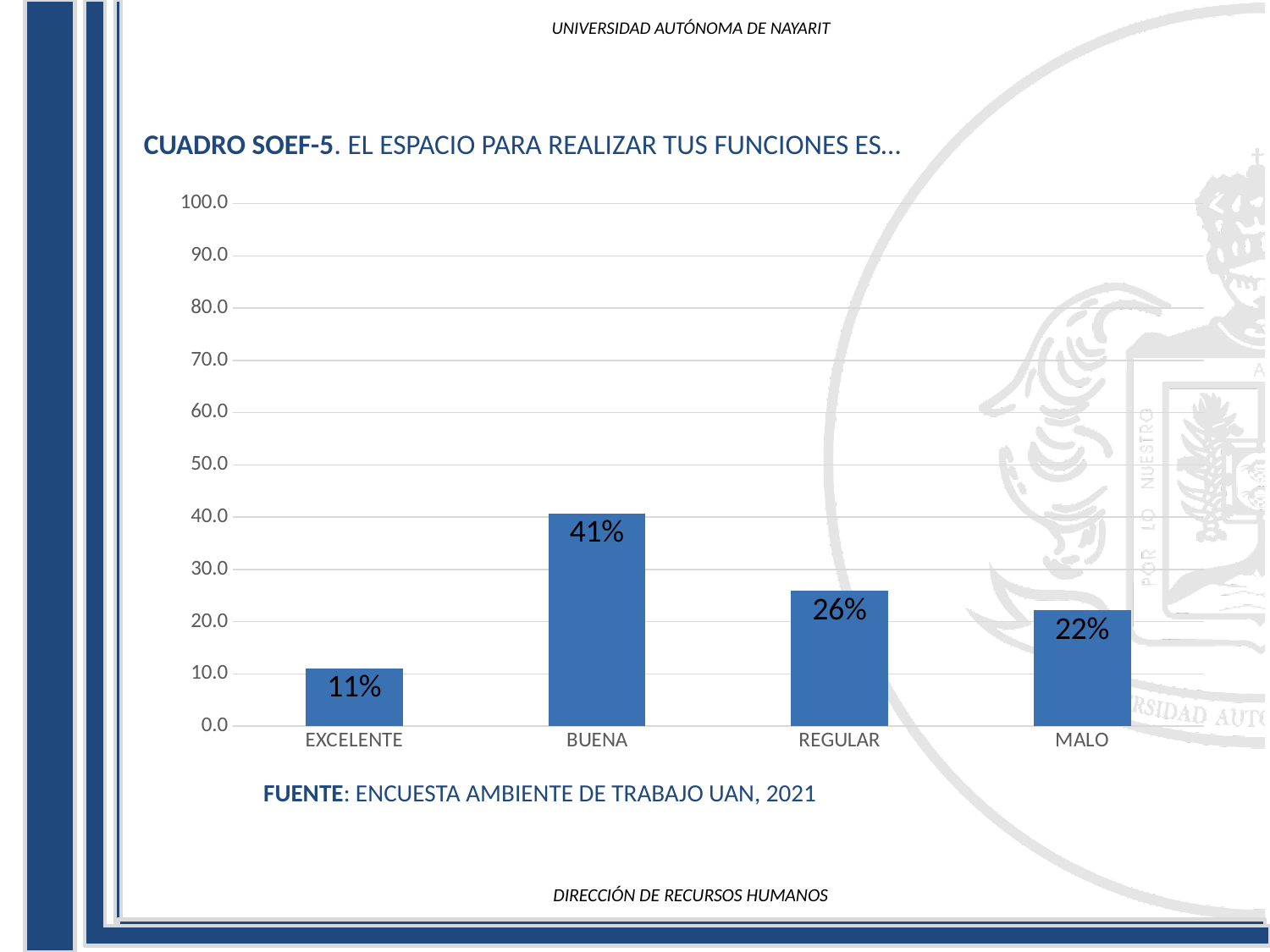
Is the value for BUENA greater or less than 50.0? less Which is larger, the value for REGULAR or the value for MALO? REGULAR What is the value for BUENA? 41% Which category has the lowest value? EXCELENTE What is the title of the chart? CUADRO SOEF-5. EL ESPACIO PARA REALIZAR TUS FUNCIONES ES… What kind of chart is shown on the slide? bar chart What is the difference between the values for BUENA and REGULAR? 15% What is the value for MALO? 22% How many categories are shown on the x axis? 4 What source is cited below the chart? ENCUESTA AMBIENTE DE TRABAJO UAN, 2021 Which category has the highest value? BUENA What is the value for EXCELENTE? 11%